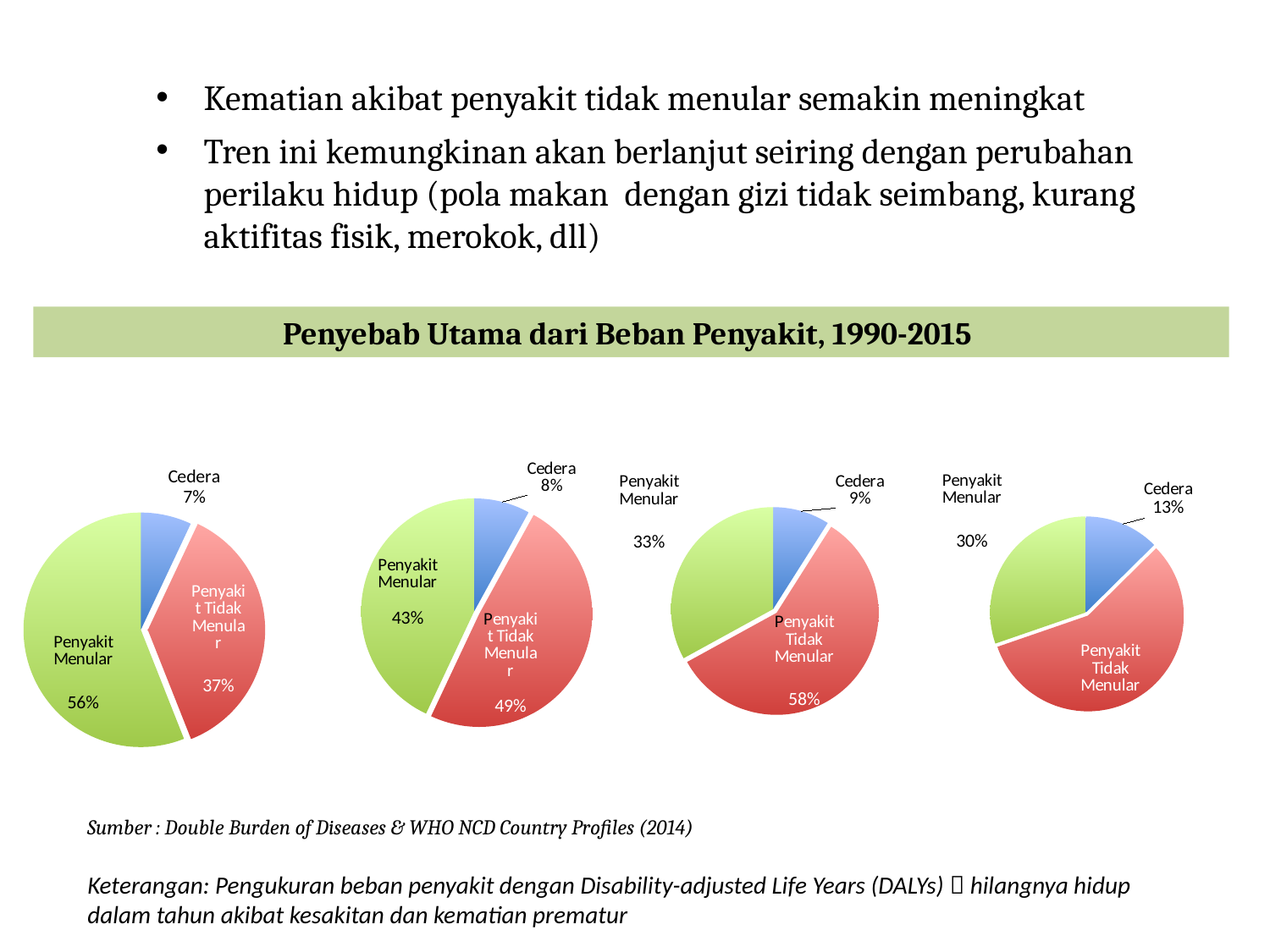
In the leftmost pie chart, what is the share for Penyakit Menular? 56% In the second pie chart from the left, what is the share for Penyakit Tidak Menular? 49% How many pie charts are shown on the slide? 4 In the third pie chart from the left, what is the share for Penyakit Menular? 33% In the rightmost pie chart, what is the share for Cedera? 13% In the leftmost pie chart, what is the share for Cedera? 7% In the second pie chart from the left, which is larger: Penyakit Menular or Penyakit Tidak Menular? Penyakit Tidak Menular In the leftmost pie chart, which category has the largest share? Penyakit Menular Does the share for Cedera rise or fall moving from the leftmost pie chart to the rightmost pie chart? Rises In the third pie chart from the left, which category has the smallest share? Cedera In the leftmost pie chart, what is the difference between the shares of Penyakit Menular and Penyakit Tidak Menular? 19% What kind of charts are shown on the slide under the heading 'Penyebab Utama dari Beban Penyakit, 1990-2015'? Pie charts